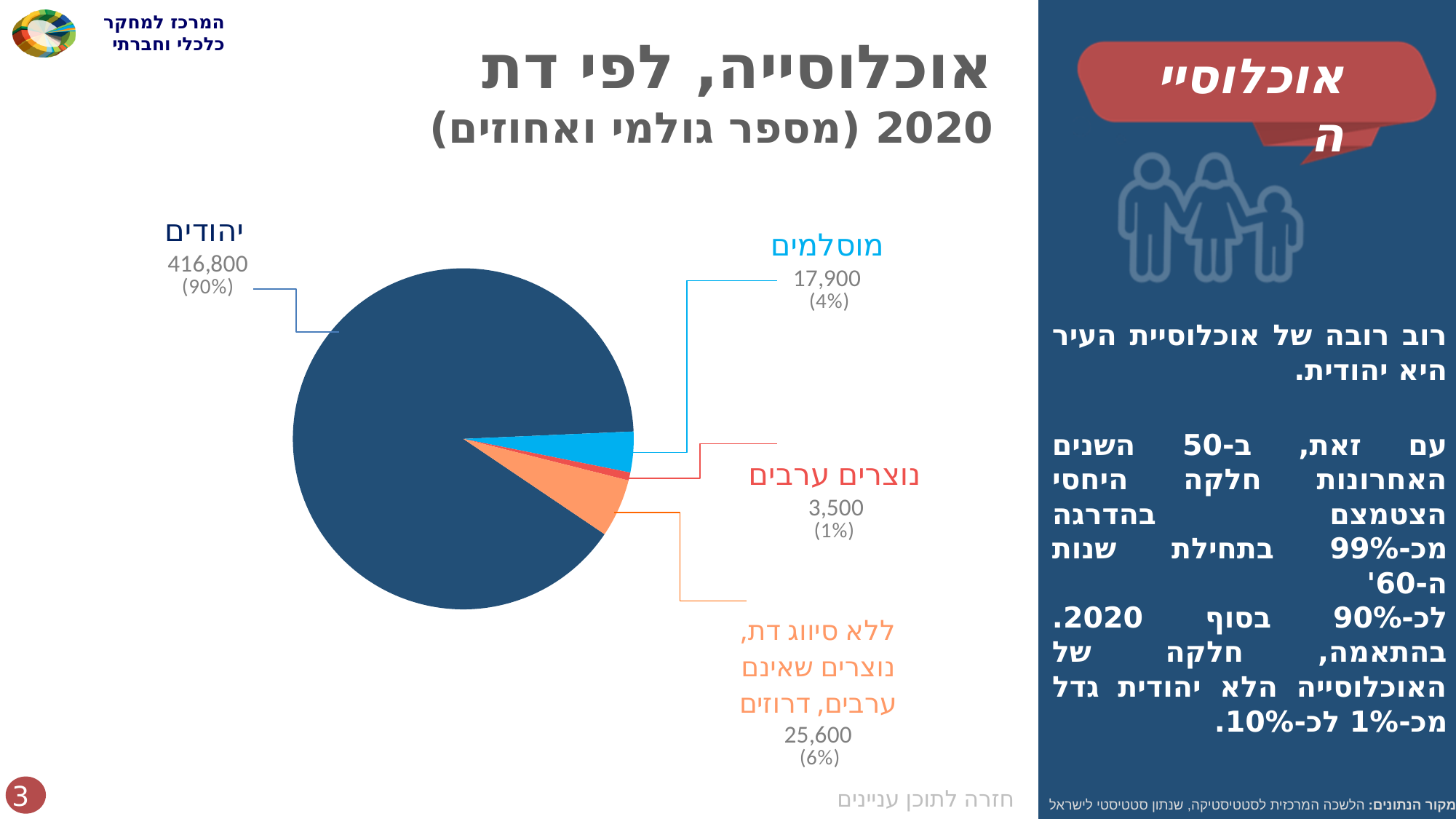
What is the value shown for the slice labelled ללא סיווג דת, נוצרים שאינם ערבים, דרוזים? 25,600 What percentage share does the יהודים slice have? 90% Which is larger: the value for מוסלמים or the value for ללא סיווג דת, נוצרים שאינם ערבים, דרוזים? ללא סיווג דת, נוצרים שאינם ערבים, דרוזים What is the difference between the values for מוסלמים and נוצרים ערבים? 14,400 What type of chart is shown on the slide? pie chart What is the value shown for מוסלמים? 17,900 Which category has the largest slice in the pie chart? יהודים How many slices does the pie chart have? 4 What is the value shown for יהודים in the pie chart? 416,800 Which category has the smallest slice in the pie chart? נוצרים ערבים What percentage share does the מוסלמים slice have? 4% What is the value shown for נוצרים ערבים? 3,500